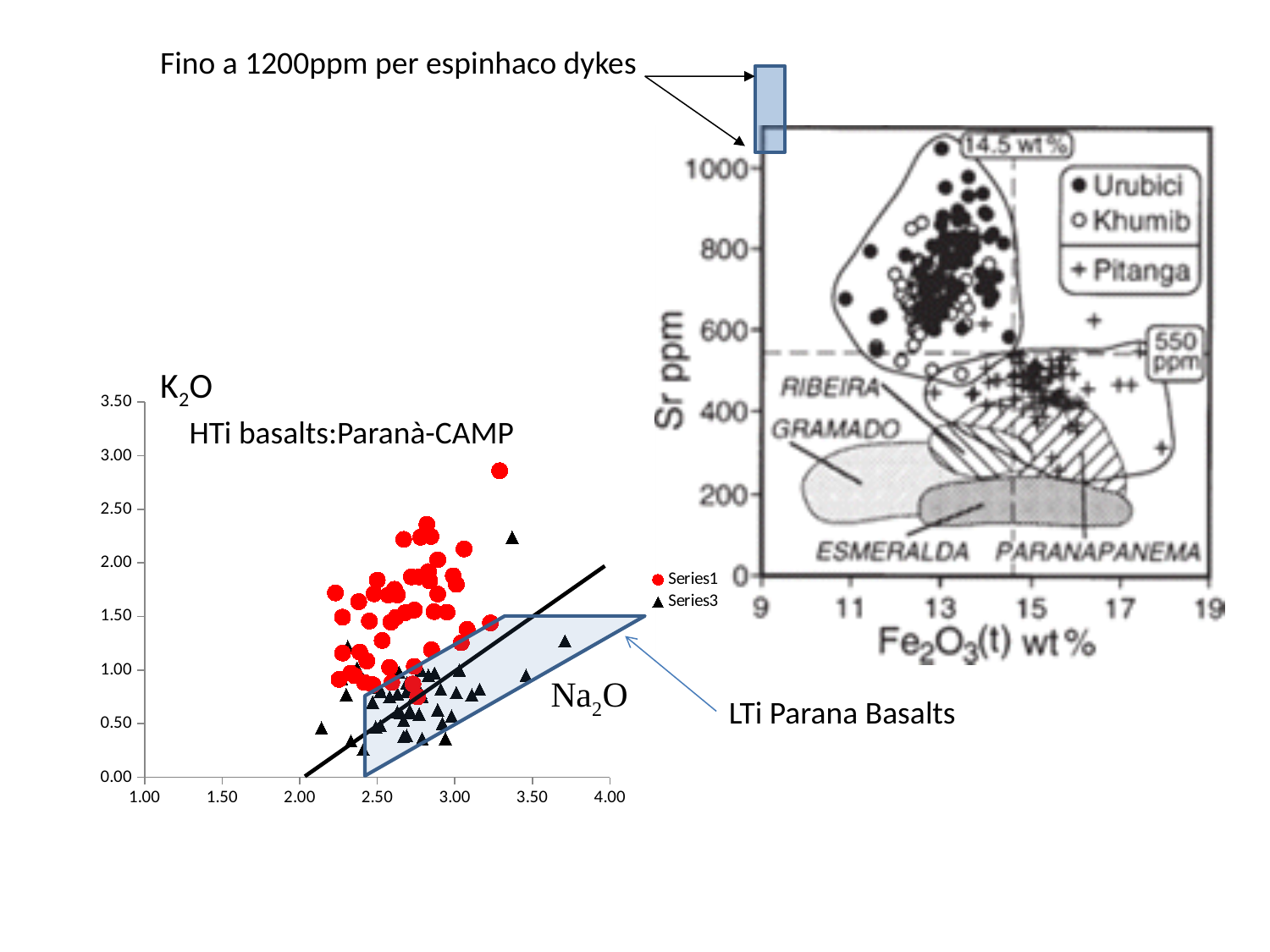
In the left K2O versus Na2O chart, is the highest K2O value among the Series1 points greater or less than 2.50? greater What is the highest tick value shown on the y axis of the left K2O versus Na2O chart? 3.50 In the left K2O versus Na2O chart, which series contains the point with the highest K2O value? Series1 In the left K2O versus Na2O chart, is the lowest K2O value among the Series3 points greater or less than 0.50? less What are the two series names in the legend of the left K2O versus Na2O chart? Series1 and Series3 In the right Sr ppm versus Fe2O3(t) wt% chart, what Sr value is marked by the horizontal dashed line? 550 ppm What are the three groups listed in the legend of the right Sr ppm versus Fe2O3(t) wt% chart? Urubici, Khumib, Pitanga What is the highest tick value shown on the x axis of the left K2O versus Na2O chart? 4.00 How many series does the legend of the left K2O versus Na2O chart list? 2 In the left K2O versus Na2O chart, is the highest K2O value among the Series3 points greater or less than 2.00? greater How many groups does the legend of the right Sr ppm versus Fe2O3(t) wt% chart list? 3 What kind of chart is the K2O versus Na2O chart on the left of the slide? scatter chart